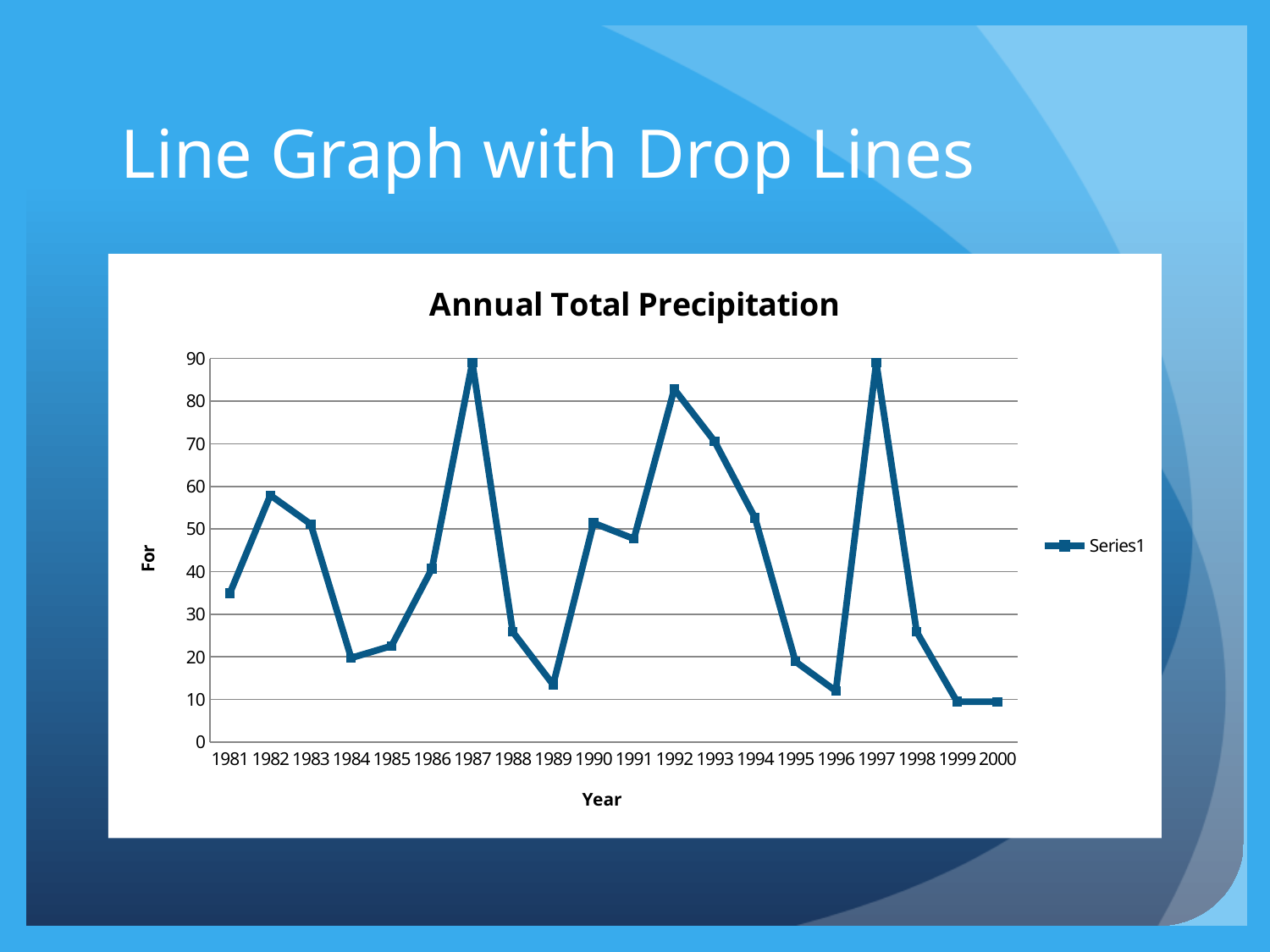
How many series does the legend list? 1 Is the value for 1992 greater or less than 70? greater Do the values rise or fall from 1992 to 1996? fall What type of chart is shown on the slide? line chart What is the title of the chart? Annual Total Precipitation Which year has the larger value, 1984 or 1986? 1986 Which year has the larger value, 1982 or 1992? 1992 Is the value for 1996 greater or less than 20? less What is the label of the x axis? Year How many years are plotted along the x axis? 20 Is the value for 1989 greater or less than 20? less